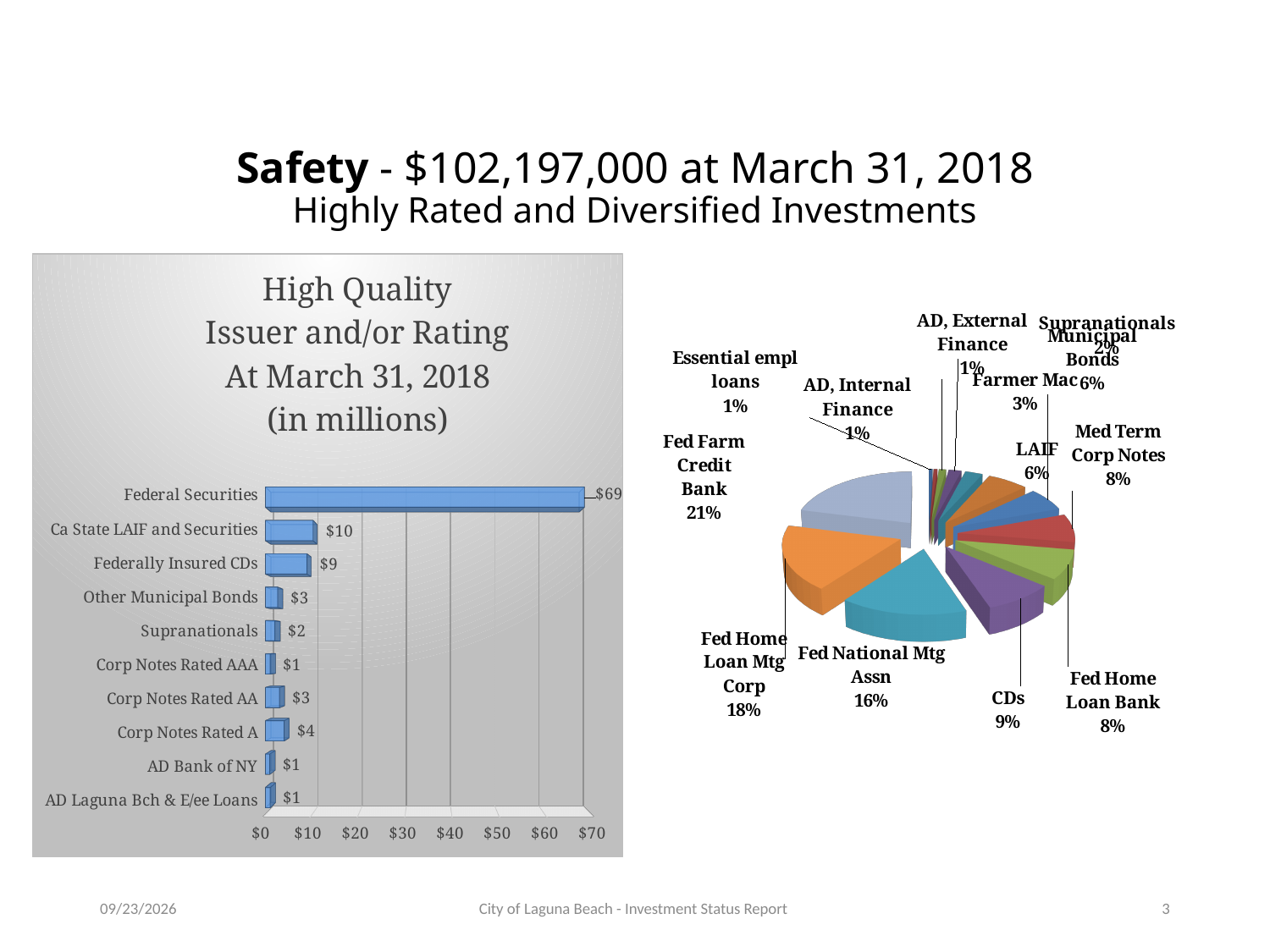
In the bar chart titled 'High Quality Issuer and/or Rating', which category has the highest value? Federal Securities What kind of chart is the chart on the right side of the slide? Pie chart In the bar chart titled 'High Quality Issuer and/or Rating', what is the difference between Federal Securities and Federally Insured CDs? $60 What kind of chart is the chart on the left side of the slide? Bar chart In the bar chart titled 'High Quality Issuer and/or Rating', what is the value for Ca State LAIF and Securities? $10 In the bar chart titled 'High Quality Issuer and/or Rating', how many categories are shown? 10 In the pie chart on the right, what share does Fed Farm Credit Bank have? 21% In the pie chart on the right, what share does Fed National Mtg Assn have? 16% In the bar chart titled 'High Quality Issuer and/or Rating', which is larger: Corp Notes Rated A or Corp Notes Rated AA? Corp Notes Rated A In the pie chart on the right, which slice is the largest? Fed Farm Credit Bank In the bar chart titled 'High Quality Issuer and/or Rating', what is the value for Federal Securities? $69 In the pie chart on the right, which is larger: CDs or Fed Home Loan Bank? CDs